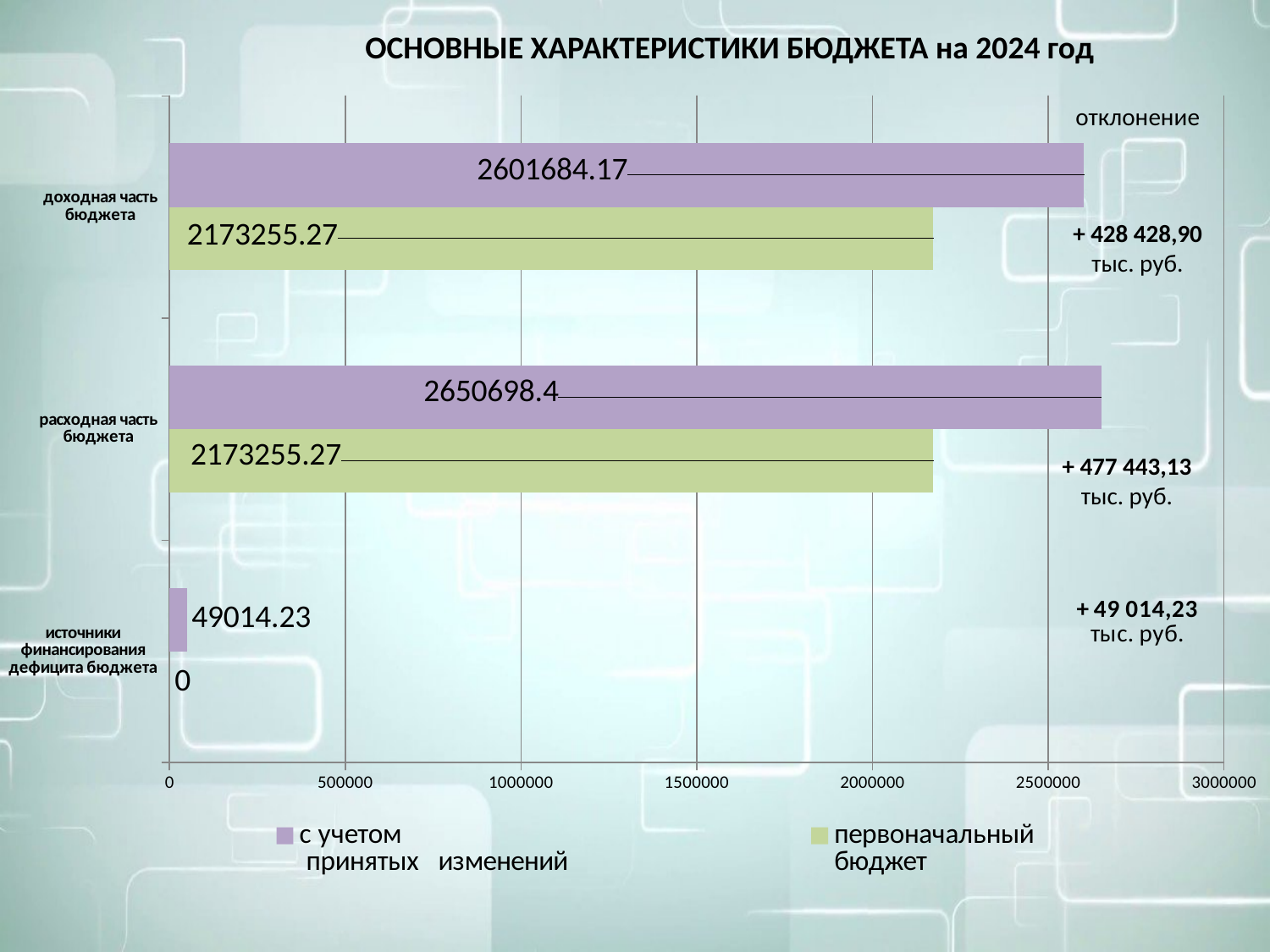
What type of chart is shown on the slide? bar chart How many categories are plotted on the chart? 3 What is the value of 'с учетом принятых изменений' for 'источники финансирования дефицита бюджета'? 49014.23 Which category has the lowest value in the 'с учетом принятых изменений' series? источники финансирования дефицита бюджета What is the title of the chart? ОСНОВНЫЕ ХАРАКТЕРИСТИКИ БЮДЖЕТА на 2024 год What is the value of 'первоначальный бюджет' for 'источники финансирования дефицита бюджета'? 0 Which category has the highest value in the 'с учетом принятых изменений' series? расходная часть бюджета What is the value of 'с учетом принятых изменений' for 'доходная часть бюджета'? 2601684.17 For 'доходная часть бюджета', which is larger: 'с учетом принятых изменений' or 'первоначальный бюджет'? с учетом принятых изменений What is the value of 'первоначальный бюджет' for 'расходная часть бюджета'? 2173255.27 What is the difference between 'с учетом принятых изменений' and 'первоначальный бюджет' for 'расходная часть бюджета'? 477443.13 How many series does the legend list? 2